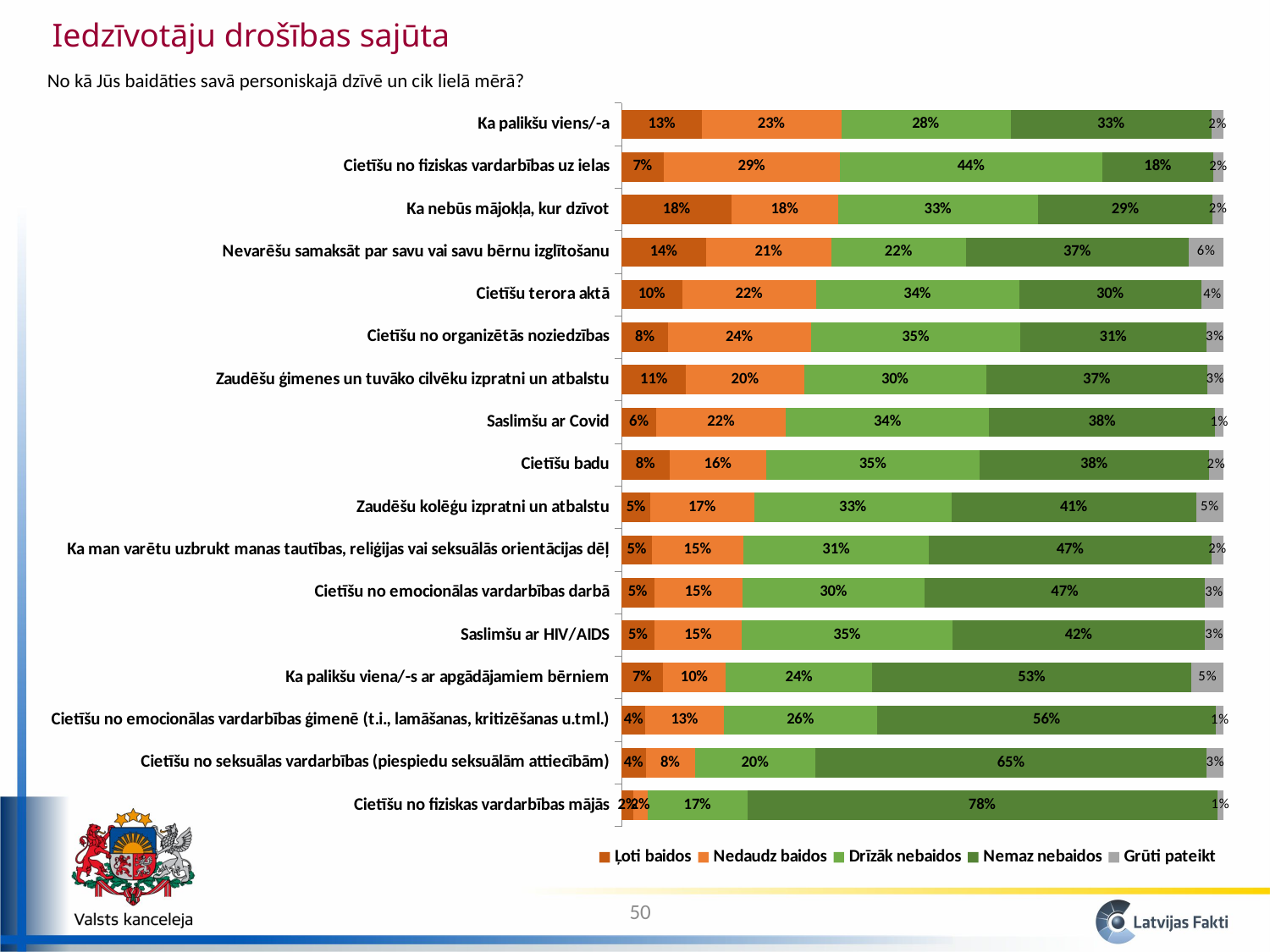
What is the "Grūti pateikt" value for "Nevarēšu samaksāt par savu vai savu bērnu izglītošanu"? 6% What percentage of respondents answered "Nemaz nebaidos" for "Cietīšu no fiziskas vardarbības mājās"? 78% What is the combined share of "Ļoti baidos" and "Nedaudz baidos" for "Ka nebūs mājokļa, kur dzīvot"? 36% How many categories (fears) are shown in the chart? 17 What is the "Ļoti baidos" value for "Ka nebūs mājokļa, kur dzīvot"? 18% How many percentage points higher is the "Nemaz nebaidos" value for "Cietīšu no seksuālas vardarbības (piespiedu seksuālām attiecībām)" than for "Ka palikšu viens/-a"? 32 percentage points Which category has the highest "Nemaz nebaidos" value? Cietīšu no fiziskas vardarbības mājās Which category has the highest "Ļoti baidos" value? Ka nebūs mājokļa, kur dzīvot What is the "Drīzāk nebaidos" value for "Cietīšu no fiziskas vardarbības uz ielas"? 44% How many series does the legend list? 5 Which has the larger "Nedaudz baidos" value: "Cietīšu no fiziskas vardarbības uz ielas" or "Ka palikšu viens/-a"? Cietīšu no fiziskas vardarbības uz ielas What kind of chart is shown on the slide? Stacked bar chart